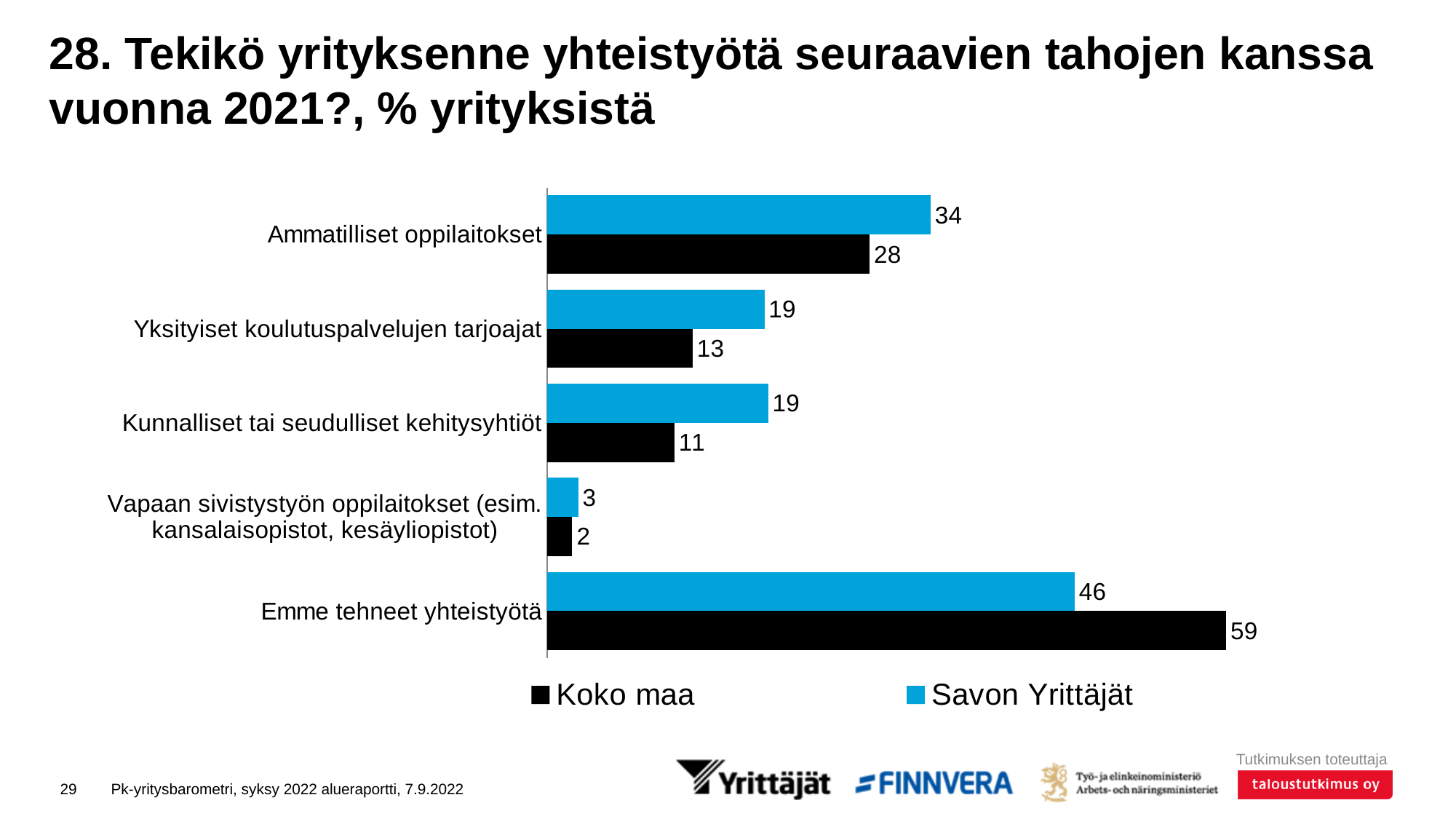
Which category has the highest value for Koko maa? Emme tehneet yhteistyötä How many series does the legend list? 2 What is the value for Savon Yrittäjät for Vapaan sivistystyön oppilaitokset (esim. kansalaisopistot, kesäyliopistot)? 3 What is the value for Savon Yrittäjät for Ammatilliset oppilaitokset? 34 How many categories are shown on the chart? 5 What is the value for Koko maa for Kunnalliset tai seudulliset kehitysyhtiöt? 11 What kind of chart is shown on the slide? Bar chart What is the value for Koko maa for Emme tehneet yhteistyötä? 59 Which category has the lowest value for Savon Yrittäjät? Vapaan sivistystyön oppilaitokset (esim. kansalaisopistot, kesäyliopistot) What is the difference between the Savon Yrittäjät and Koko maa values for Yksityiset koulutuspalvelujen tarjoajat? 6 For Ammatilliset oppilaitokset, which series has the larger value, Koko maa or Savon Yrittäjät? Savon Yrittäjät What is the difference between the Koko maa and Savon Yrittäjät values for Emme tehneet yhteistyötä? 13